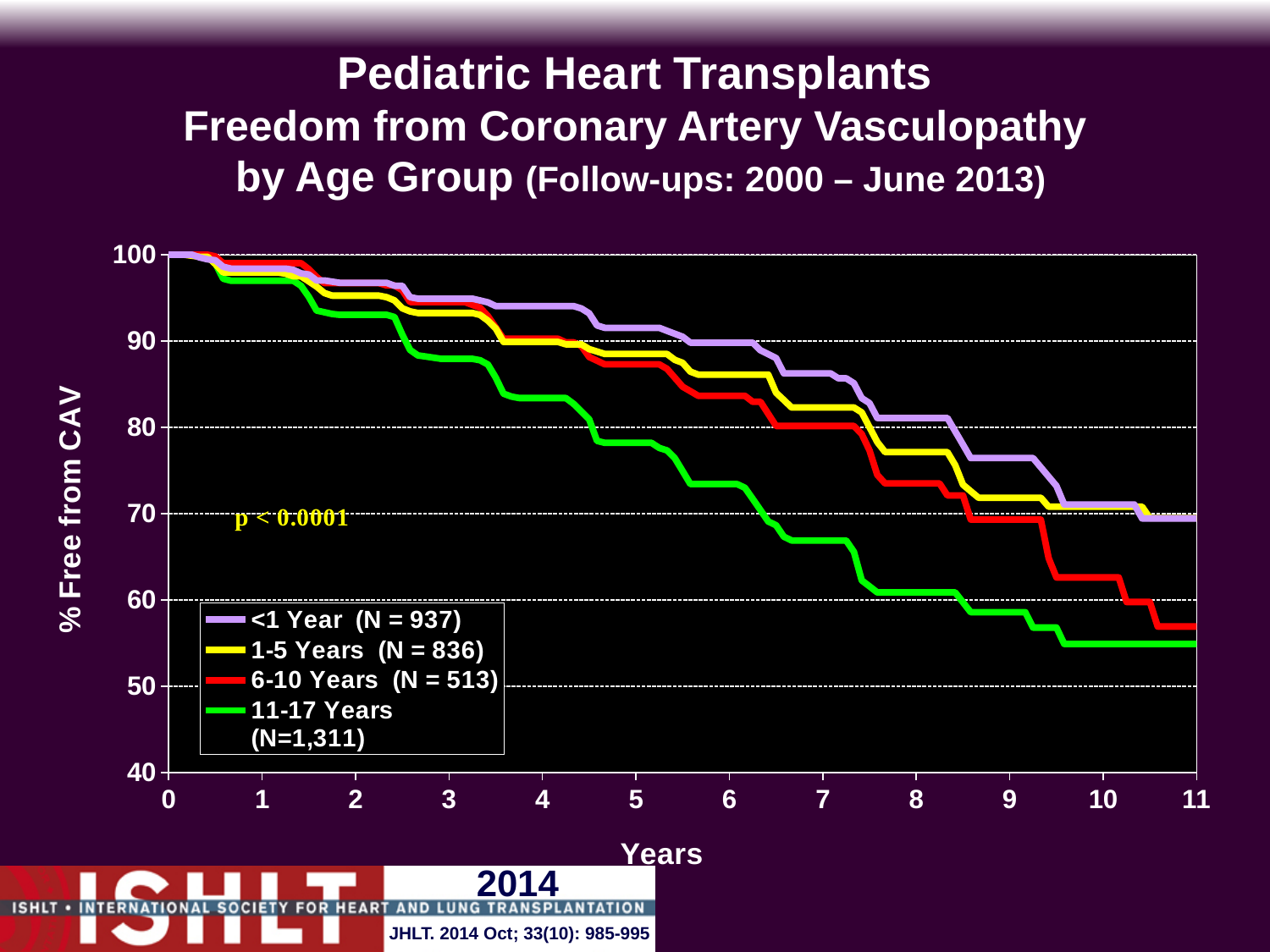
Which age group has the lowest % free from CAV at year 11? 11-17 Years Do the curves rise or fall as years since transplant increase? fall Is the value for the <1 Year group at year 5 greater or less than 90? greater What is the N for the 11-17 Years group shown in the legend? N=1,311 What kind of chart is shown on the slide? line chart Is the value for the 11-17 Years group at year 11 greater or less than 60? less At year 11, which group has a higher % free from CAV: <1 Year or 11-17 Years? <1 Year Is the value for the 6-10 Years group at year 8 greater or less than 70? greater What p-value is printed on the chart? p < 0.0001 How many series does the legend list? 4